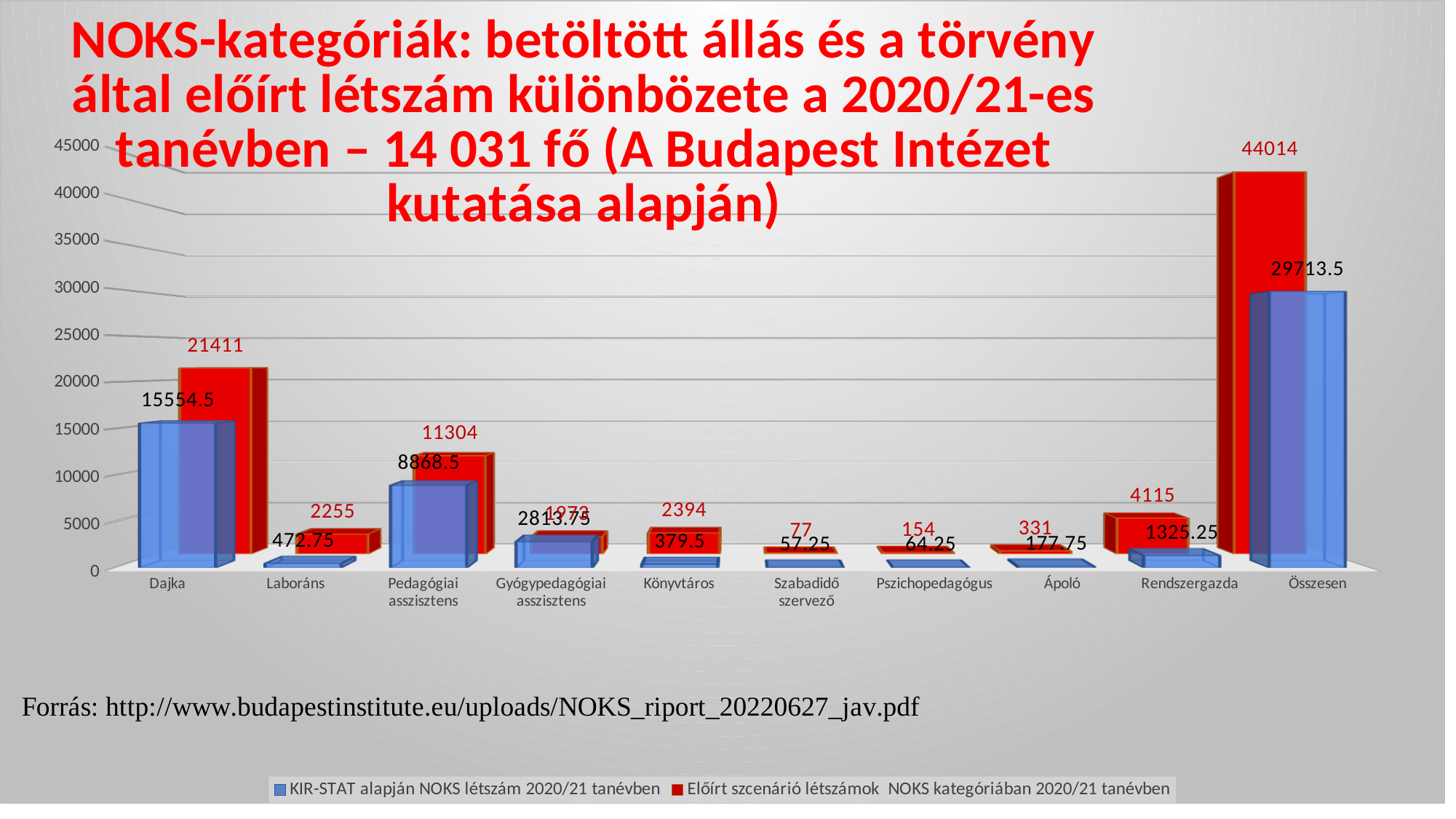
Is the KIR-STAT value for Összesen greater or less than 25000? greater What is the value of the Előírt szcenárió létszámok series for Rendszergazda? 4115 What is the value of the KIR-STAT alapján NOKS létszám 2020/21 tanévben series for Dajka? 15554.5 How many series does the legend list? 2 What is the difference between the Előírt szcenárió and KIR-STAT values for Laboráns? 1782.25 Which category has the lowest value in the KIR-STAT alapján NOKS létszám series? Szabadidő szervező What is the value of the Előírt szcenárió létszámok series for Összesen? 44014 What is the KIR-STAT alapján NOKS létszám value for Könyvtáros? 379.5 For Pedagógiai asszisztens, which is larger: the KIR-STAT value or the Előírt szcenárió value? Előírt szcenárió value What is the difference between the Előírt szcenárió and KIR-STAT values for Dajka? 5856.5 How many categories are shown on the x axis? 10 Which category has the highest value in the Előírt szcenárió létszámok series? Összesen